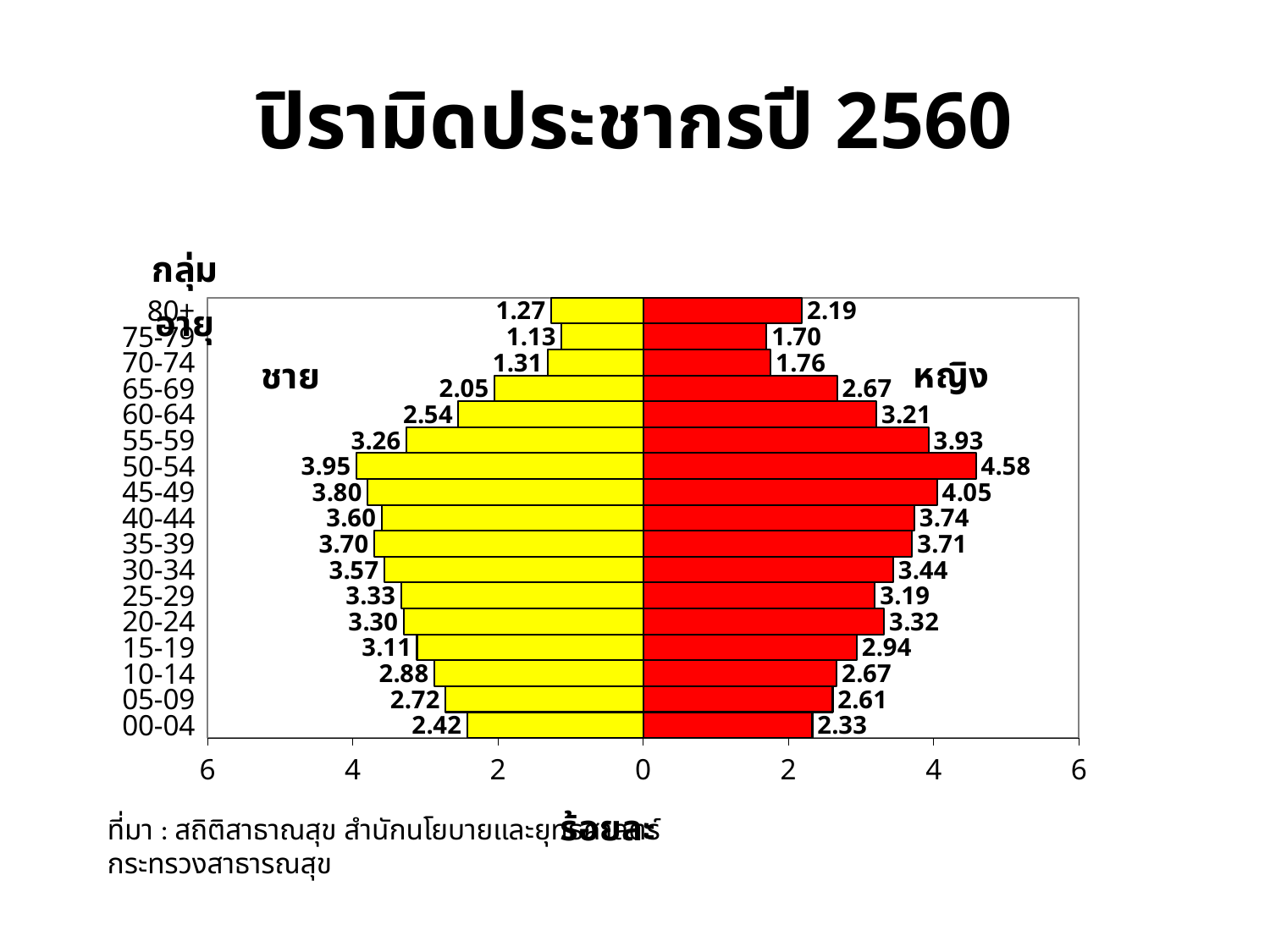
Which age group has the highest value for females (หญิง)? 50-54 How many age groups are shown on the chart? 17 In the 15-19 age group, which is larger: the male (ชาย) value or the female (หญิง) value? male (ชาย) What is the title of the chart on the slide? ปิรามิดประชากรปี 2560 What is the difference between the female (หญิง) and male (ชาย) values in the 50-54 age group? 0.63 Which age group has the lowest value for males (ชาย)? 75-79 In the 20-24 age group, which is larger: the male (ชาย) value or the female (หญิง) value? female (หญิง) What is the value for females (หญิง) in the 00-04 age group? 2.33 What is the value for males (ชาย) in the 50-54 age group? 3.95 Which colour represents males (ชาย) on the chart? yellow What kind of chart is shown on the slide? bar chart (population pyramid) What is the value for females (หญิง) in the 75-79 age group? 1.70